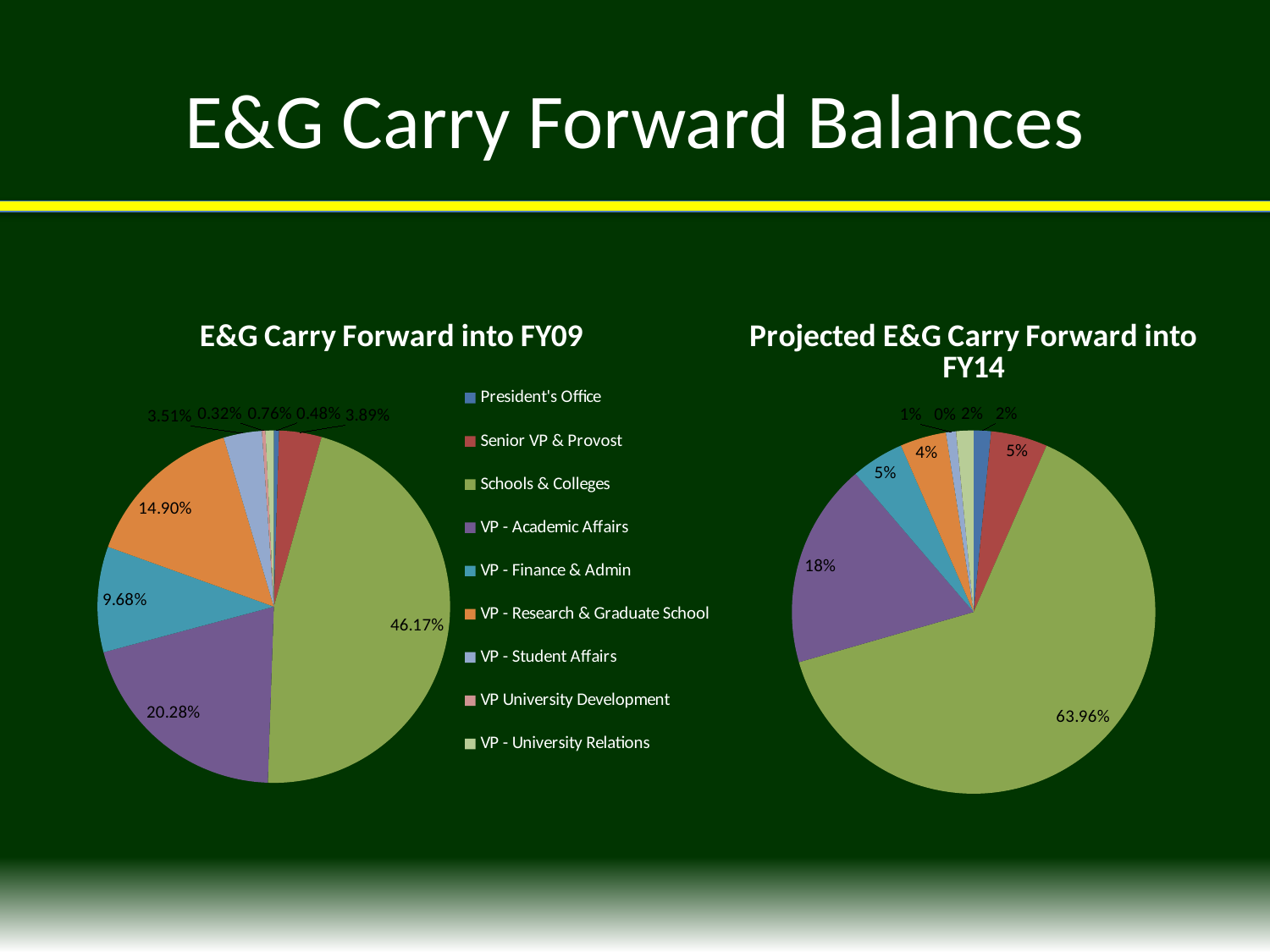
In the 'E&G Carry Forward into FY09' chart, which category has the largest slice? Schools & Colleges In the 'E&G Carry Forward into FY09' chart, what share does VP - Research & Graduate School have? 14.90% In the 'E&G Carry Forward into FY09' chart, which is larger: VP - Academic Affairs or VP - Research & Graduate School? VP - Academic Affairs What kind of chart is the 'E&G Carry Forward into FY09' chart? pie chart How many categories does the legend of the 'E&G Carry Forward into FY09' chart list? 9 In the 'E&G Carry Forward into FY09' chart, what share does VP - Finance & Admin have? 9.68% In the 'E&G Carry Forward into FY09' chart, which category has the smallest slice? VP University Development In the 'Projected E&G Carry Forward into FY14' chart, what is the value of the largest slice? 63.96% In the 'E&G Carry Forward into FY09' chart, how many percentage points larger is Schools & Colleges than VP - Academic Affairs? 25.89% What is the title of the pie chart on the right side of the slide? Projected E&G Carry Forward into FY14 In the 'E&G Carry Forward into FY09' chart, what share does VP - Academic Affairs have? 20.28% In the 'E&G Carry Forward into FY09' chart, what share does Schools & Colleges have? 46.17%